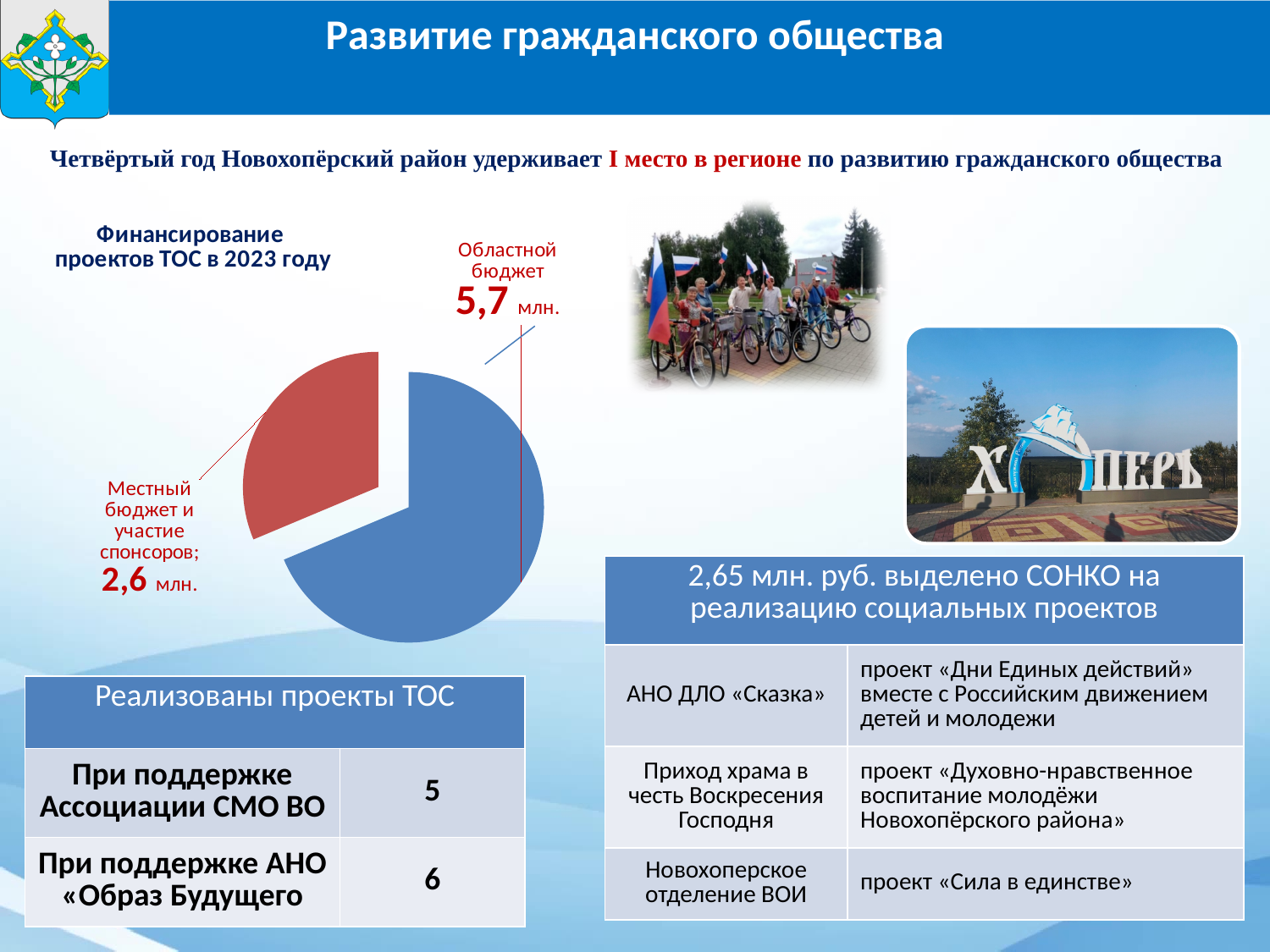
What colour is the slice for Областной бюджет in the pie chart? blue How many slices does the pie chart have? 2 What is the value for Местный бюджет и участие спонсоров in the pie chart? 2,6 млн. What is the title of the pie chart on the slide? Финансирование проектов ТОС в 2023 году By how much does Областной бюджет exceed Местный бюджет и участие спонсоров in the pie chart? 3,1 млн. Which funding source has the smallest slice in the pie chart? Местный бюджет и участие спонсоров Which funding source has the largest slice in the pie chart? Областной бюджет What is the total financing of TOS projects in 2023 shown by the two slices of the pie chart? 8,3 млн. What is the value for Областной бюджет in the pie chart? 5,7 млн. Which is larger in the pie chart: Областной бюджет or Местный бюджет и участие спонсоров? Областной бюджет What kind of chart is used to show the financing of TOS projects in 2023? pie chart